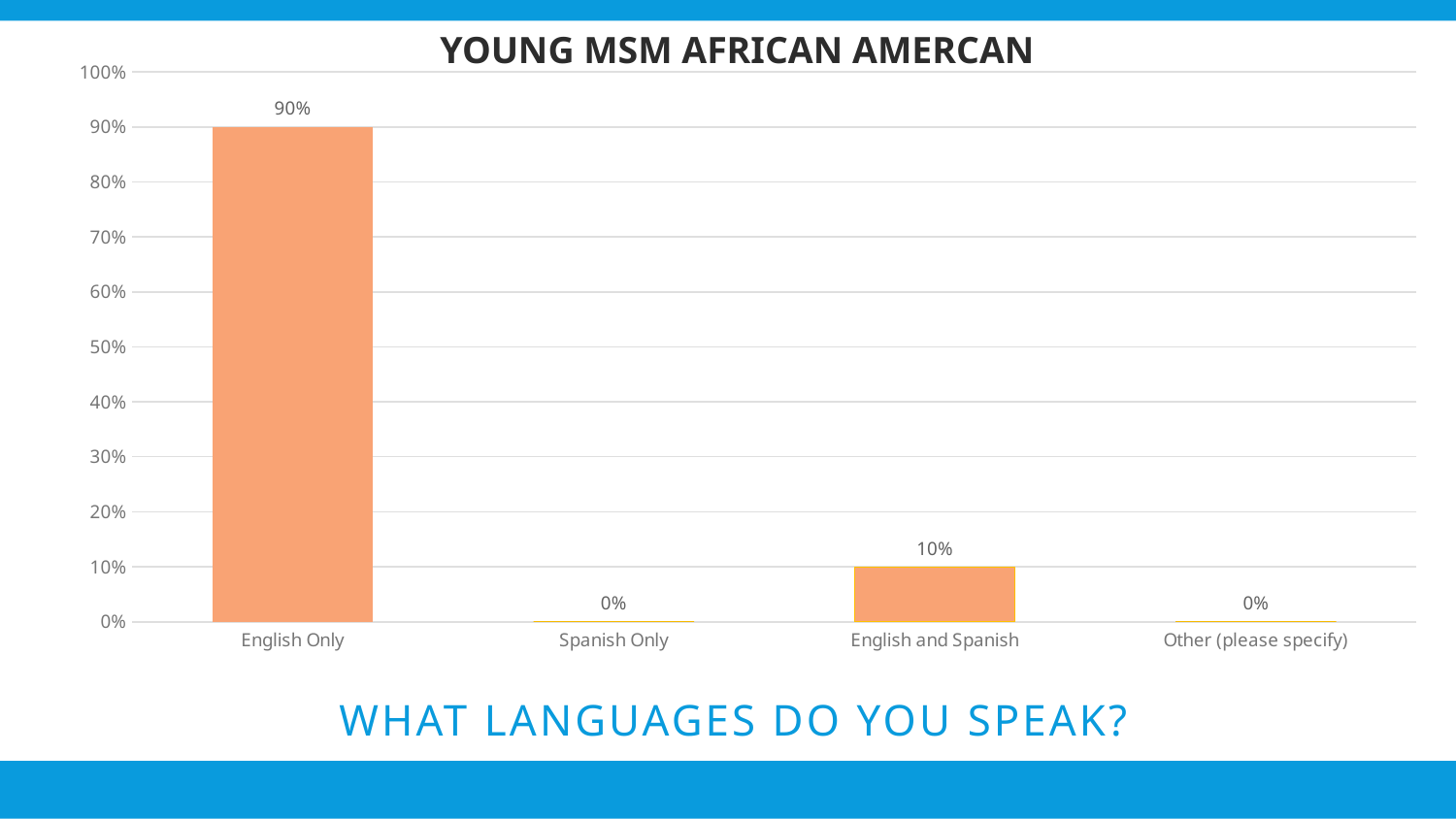
What kind of chart is shown on the slide? bar chart What is the value for English and Spanish? 10% What is the value for Other (please specify)? 0% Which category has the highest value? English Only Which is larger, the value for English Only or the value for English and Spanish? English Only What is the value for English Only? 90% What is the title of the chart? YOUNG MSM AFRICAN AMERCAN What is the total of the values for English Only and English and Spanish? 100% Is the value for English Only greater or less than 50%? greater What is the value for Spanish Only? 0% What is the difference between the values for English Only and English and Spanish? 80% How many categories are shown on the x axis? 4